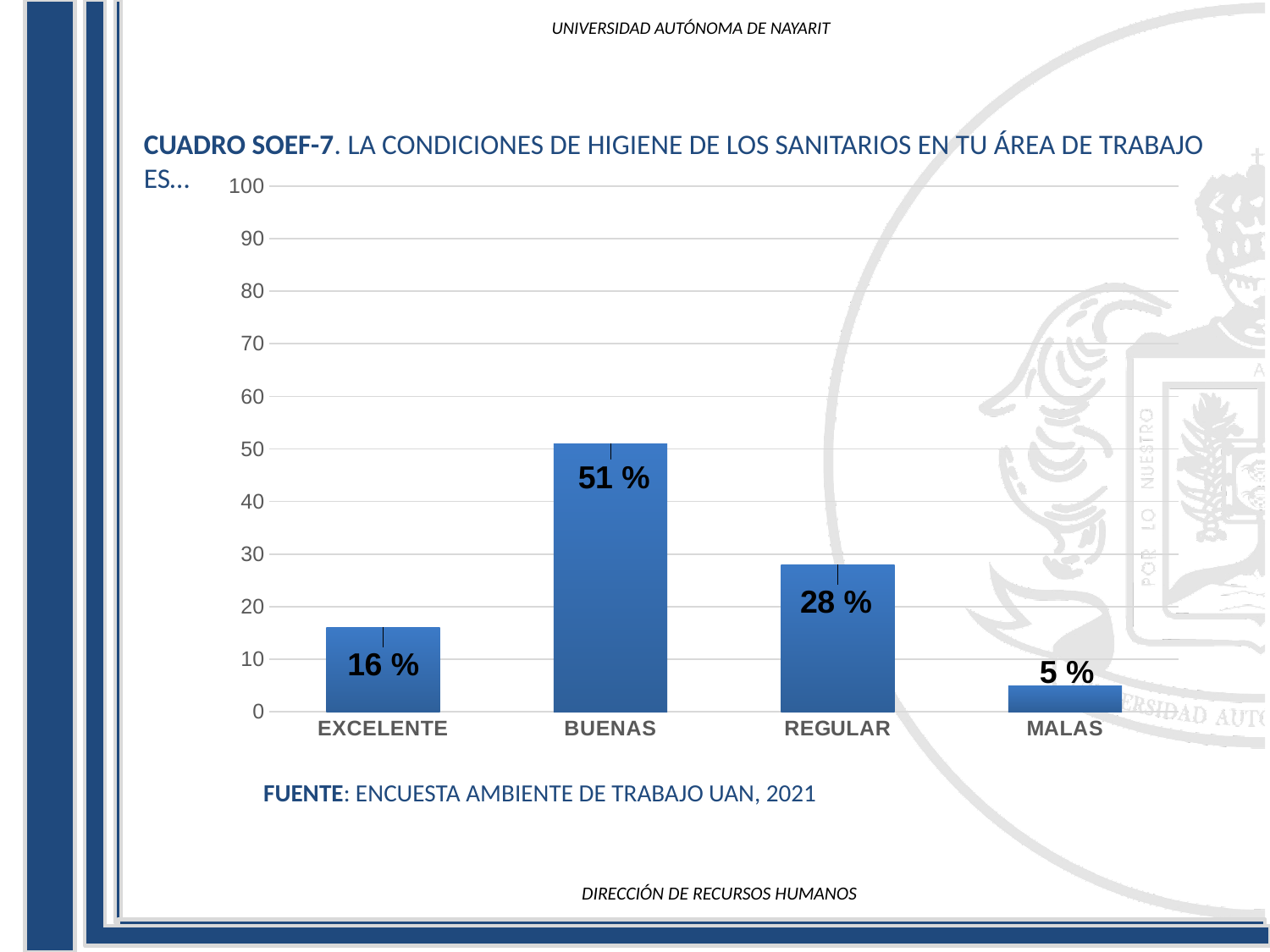
What is the value for REGULAR? 28 % What is the value for EXCELENTE? 16 % Which category has the highest value? BUENAS How many categories are shown on the x axis? 4 Is the value for BUENAS greater or less than 50? greater What source is cited below the chart? ENCUESTA AMBIENTE DE TRABAJO UAN, 2021 What is the difference between the values for BUENAS and REGULAR? 23 % Which category has the lowest value? MALAS What kind of chart is shown on the slide? bar chart Which is larger, the value for EXCELENTE or the value for REGULAR? REGULAR What is the value for MALAS? 5 % What is the value for BUENAS? 51 %